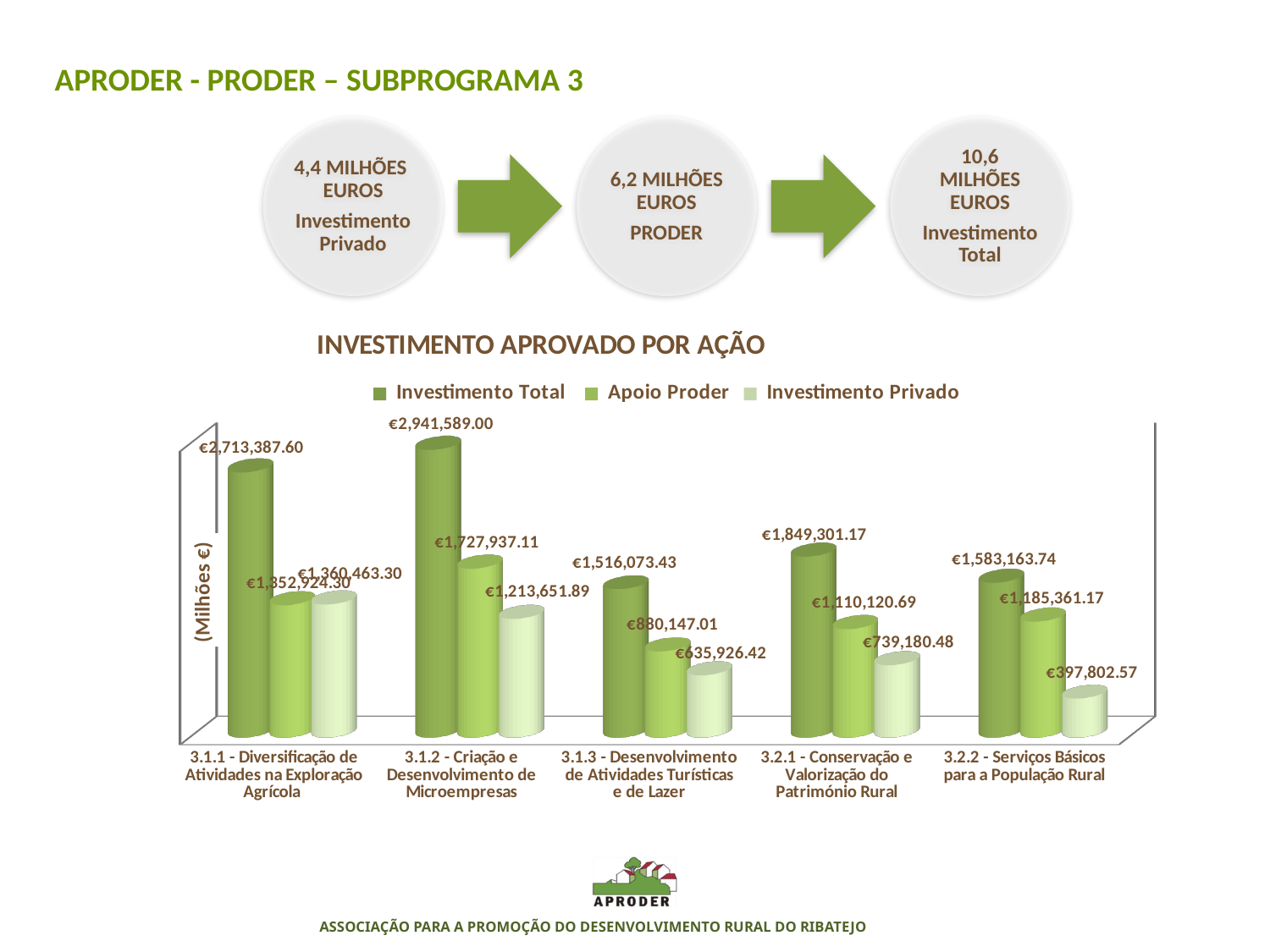
Which category has the highest Investimento Total? 3.1.2 - Criação e Desenvolvimento de Microempresas What is the Investimento Privado value for 3.1.3 - Desenvolvimento de Atividades Turísticas e de Lazer? €635,926.42 What is the Investimento Total for 3.2.1 - Conservação e Valorização do Património Rural? €1,849,301.17 Which category has the lowest Investimento Privado? 3.2.2 - Serviços Básicos para a População Rural What is the label on the vertical axis of the chart? (Milhões €) For 3.2.2 - Serviços Básicos para a População Rural, how much larger is Apoio Proder than Investimento Privado? €787,558.60 What is the Apoio Proder value for 3.1.2 - Criação e Desenvolvimento de Microempresas? €1,727,937.11 How many series does the legend of the chart list? 3 What type of chart is shown under the title 'INVESTIMENTO APROVADO POR AÇÃO'? Bar chart How many categories (ações) are shown along the x axis of the chart? 5 What is the title of the chart? INVESTIMENTO APROVADO POR AÇÃO Which has the larger Investimento Total: 3.1.3 - Desenvolvimento de Atividades Turísticas e de Lazer or 3.2.2 - Serviços Básicos para a População Rural? 3.2.2 - Serviços Básicos para a População Rural